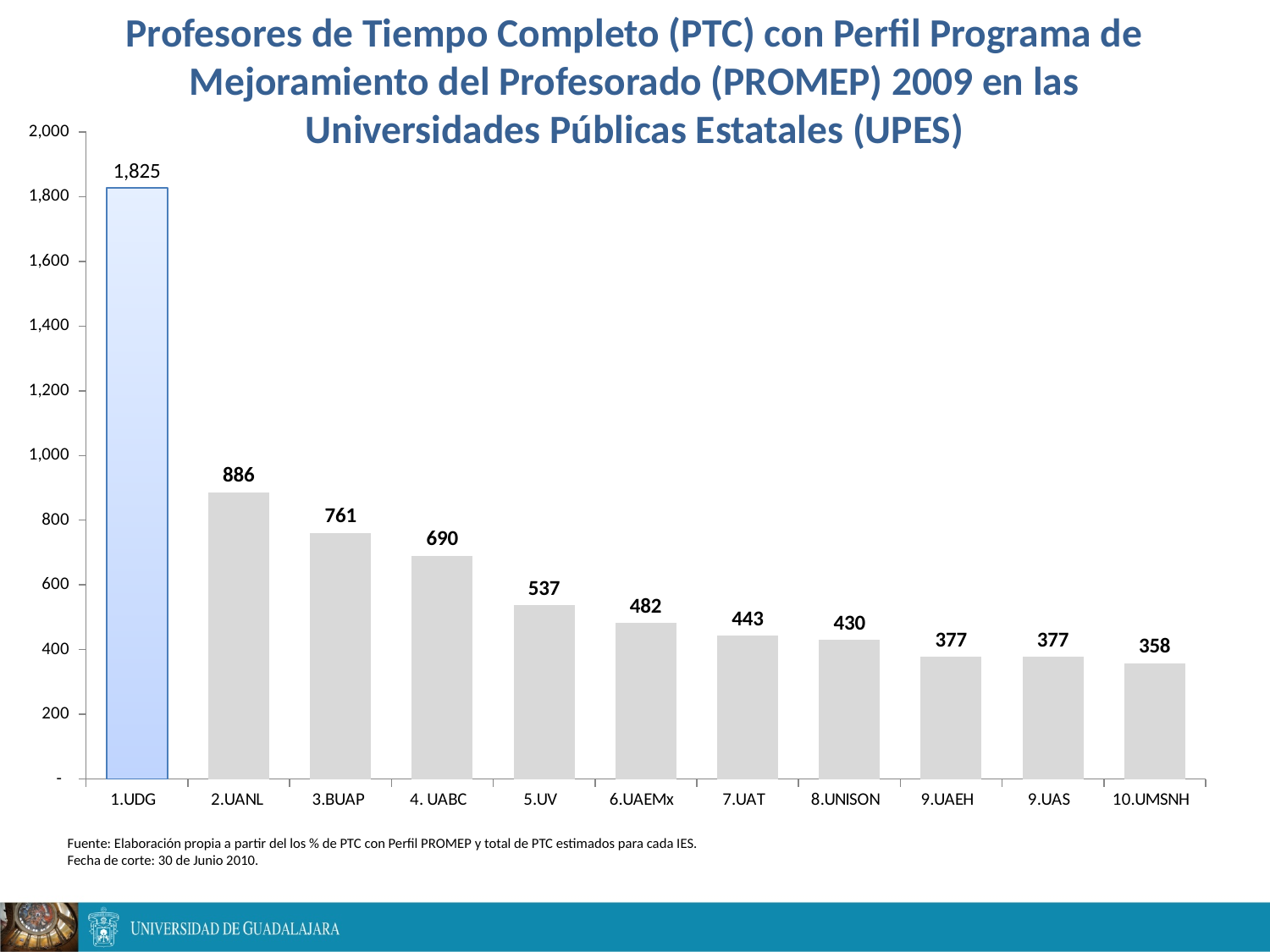
What is the difference between the values for 4. UABC and 5.UV? 153 What is the value for 3.BUAP? 761 Which is larger, the value for 6.UAEMx or the value for 7.UAT? 6.UAEMx Is the value for 2.UANL greater or less than 1,000? less How many categories are shown on the x axis? 11 What is the value for 8.UNISON? 430 Which category has the highest value? 1.UDG What kind of chart is shown on the slide? bar chart Do the values rise or fall from left to right along the x axis? fall Which category has the lowest value? 10.UMSNH What is the value for 1.UDG? 1,825 What is the difference between the values for 1.UDG and 2.UANL? 939